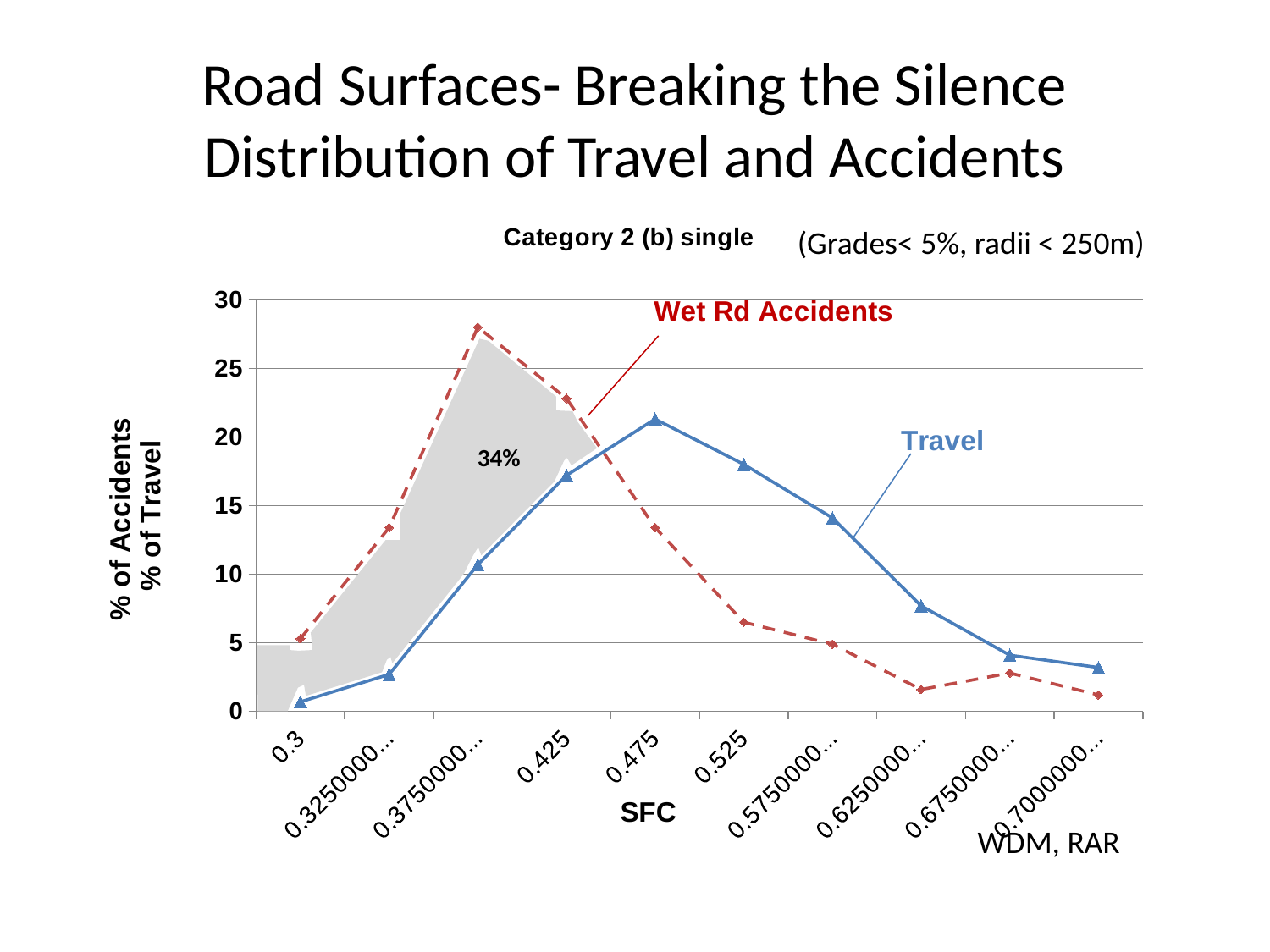
At which SFC category does the Travel series reach its highest value? 0.475 At SFC 0.525, which series has the larger value, Wet Rd Accidents or Travel? Travel Is the value for Wet Rd Accidents at SFC 0.3750000... greater or less than 25? greater How many categories are shown on the x axis of the chart? 10 What kind of chart is shown on the slide? line chart Does the Travel series rise or fall from SFC 0.475 to SFC 0.7000000...? fall How many data series are plotted on the chart? 2 Is the value for Travel at SFC 0.3 greater or less than 5? less What is the x-axis title of the chart? SFC At which SFC category does the Wet Rd Accidents series reach its highest value? 0.3750000... Is the value for Travel at SFC 0.6250000... greater or less than 10? less What is the title of the chart? Category 2 (b) single